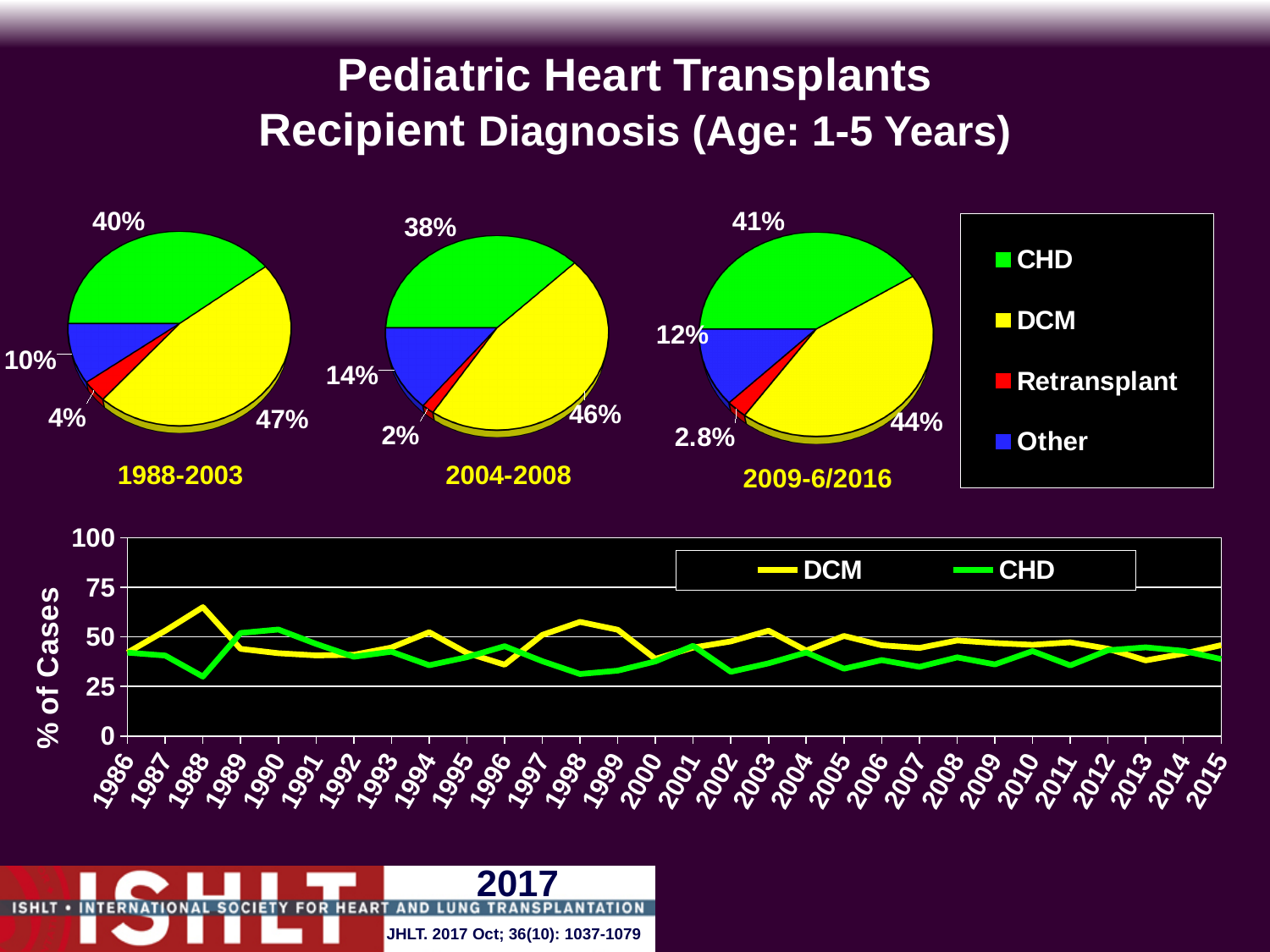
In the line chart at the bottom, how many series does the legend list? 2 In the 2009-6/2016 pie chart, which diagnosis has the largest share? DCM In the line chart at the bottom, is the CHD value for 1988 greater or less than 50? less In the 2004-2008 pie chart, what share of cases is Other? 14% How many slices does each pie chart have? 4 In the 1988-2003 pie chart, what share of cases is DCM? 47% In the 2004-2008 pie chart, which diagnosis has the smallest share? Retransplant In the 1988-2003 pie chart, what is the difference between the DCM share and the CHD share? 7% In the 2004-2008 pie chart, which is larger, the CHD share or the Other share? CHD In the 2009-6/2016 pie chart, what share of cases is Retransplant? 2.8% What type of chart is shown at the bottom of the slide? Line chart In the line chart at the bottom, is the DCM value for 1988 greater or less than 50? greater